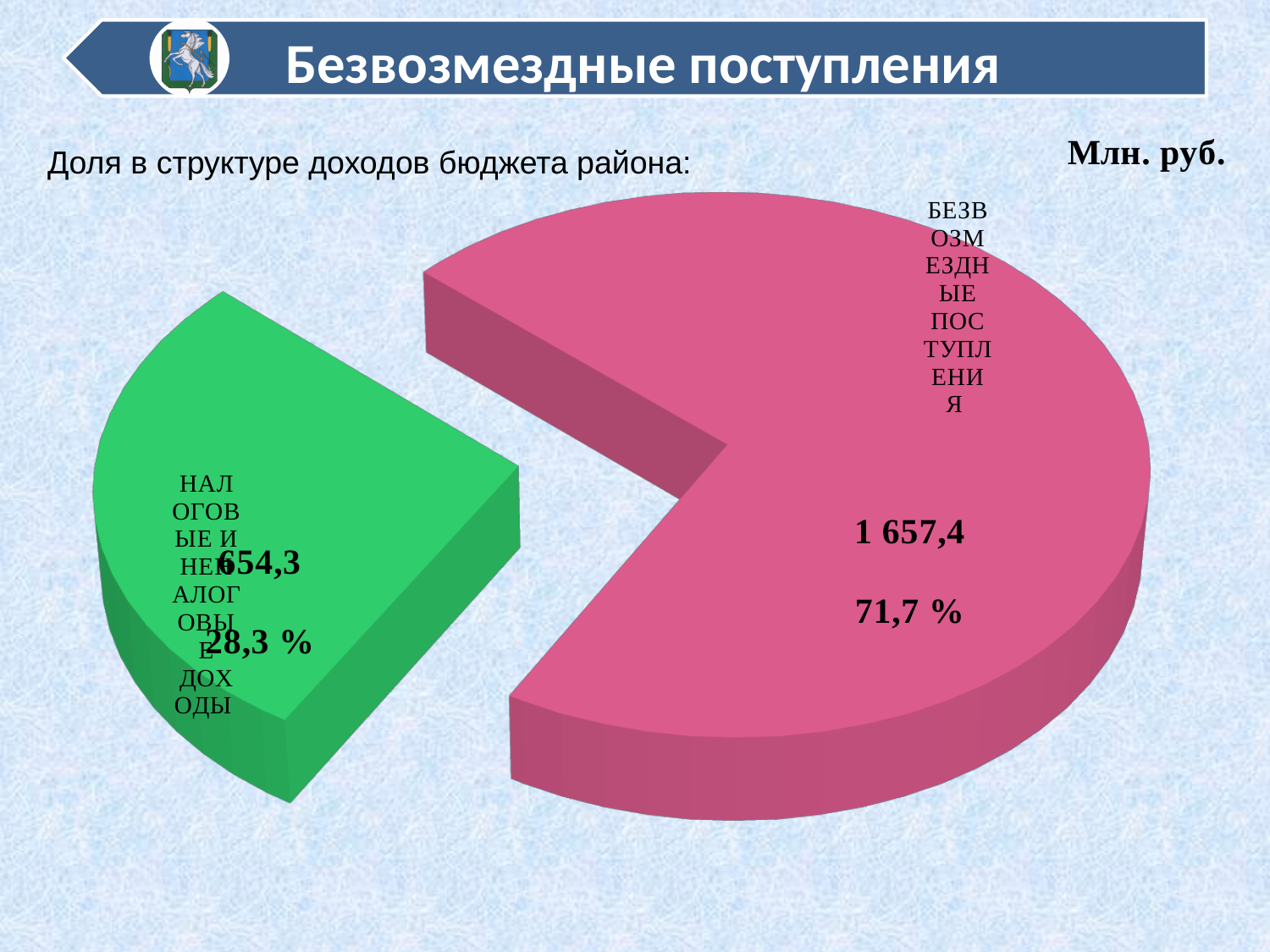
What unit is stated for the values on the chart? Млн. руб. What is the difference between the values for БЕЗВОЗМЕЗДНЫЕ ПОСТУПЛЕНИЯ and НАЛОГОВЫЕ И НЕНАЛОГОВЫЕ ДОХОДЫ? 1 003,1 What is the value for БЕЗВОЗМЕЗДНЫЕ ПОСТУПЛЕНИЯ? 1 657,4 What share of the pie does БЕЗВОЗМЕЗДНЫЕ ПОСТУПЛЕНИЯ represent? 71,7 % What is the value for НАЛОГОВЫЕ И НЕНАЛОГОВЫЕ ДОХОДЫ? 654,3 What kind of chart is shown on the slide? pie chart Which is larger, БЕЗВОЗМЕЗДНЫЕ ПОСТУПЛЕНИЯ or НАЛОГОВЫЕ И НЕНАЛОГОВЫЕ ДОХОДЫ? БЕЗВОЗМЕЗДНЫЕ ПОСТУПЛЕНИЯ How many slices does the pie chart have? 2 What colour is the slice for НАЛОГОВЫЕ И НЕНАЛОГОВЫЕ ДОХОДЫ? green Which slice is the largest? БЕЗВОЗМЕЗДНЫЕ ПОСТУПЛЕНИЯ What share of the pie does НАЛОГОВЫЕ И НЕНАЛОГОВЫЕ ДОХОДЫ represent? 28,3 % Which slice is the smallest? НАЛОГОВЫЕ И НЕНАЛОГОВЫЕ ДОХОДЫ